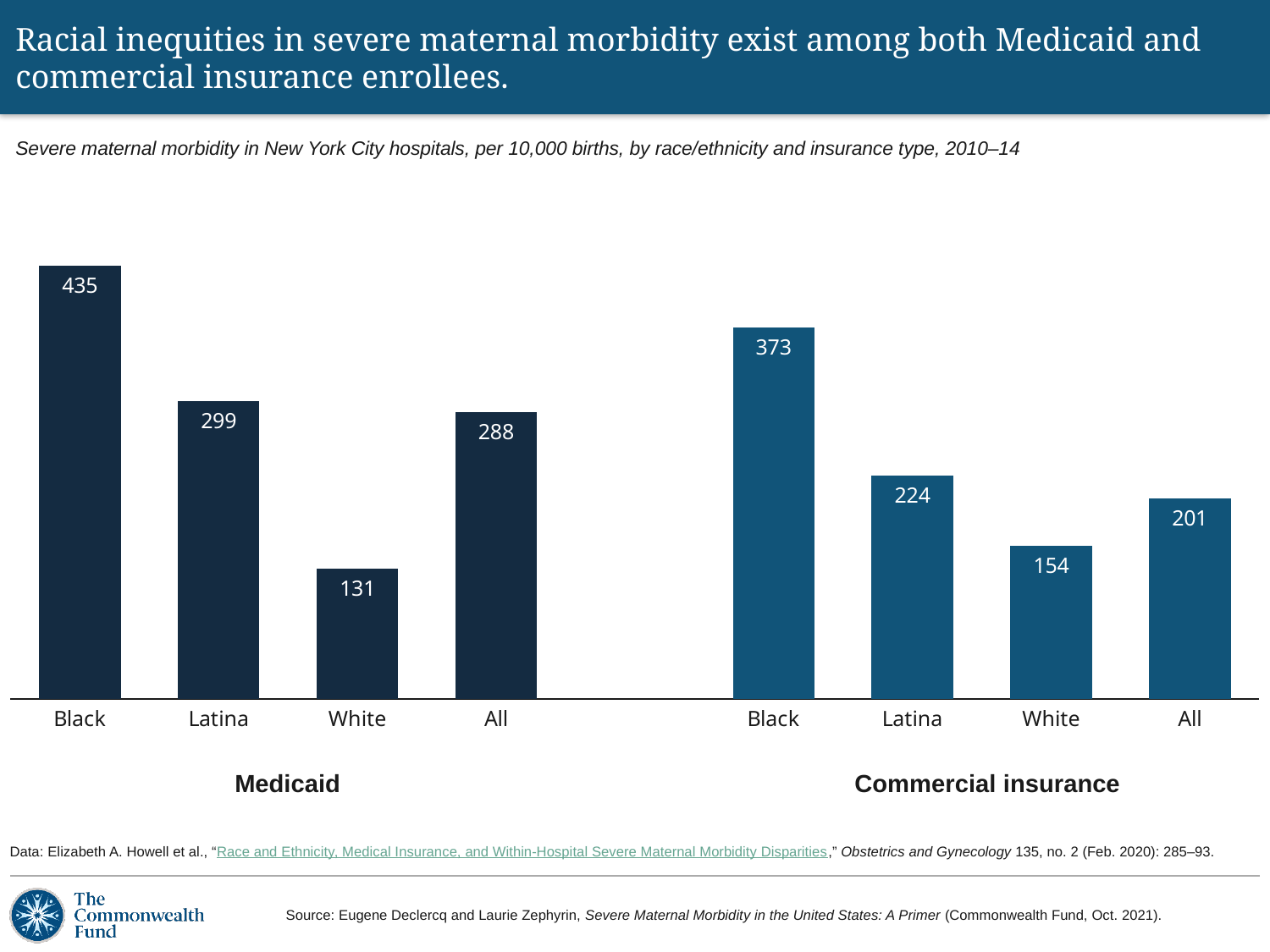
What kind of chart is shown on the slide? Bar chart What is the severe maternal morbidity rate per 10,000 births for Black Medicaid enrollees? 435 Which race/ethnicity group has the highest value among Medicaid enrollees? Black How many bars are plotted on the chart in total? 8 What are the two insurance type groups labeled on the chart? Medicaid and Commercial insurance Which is larger: the Latina value for Medicaid or the Latina value for commercial insurance? Medicaid What is the difference between the Black and White values in the Medicaid group? 304 What is the value for Latina enrollees in the Medicaid group? 299 What is the value for All enrollees with commercial insurance? 201 What is the difference between the Black Medicaid value and the Black commercial insurance value? 62 What is the value for White enrollees with commercial insurance? 154 Which race/ethnicity group has the lowest value among commercial insurance enrollees? White